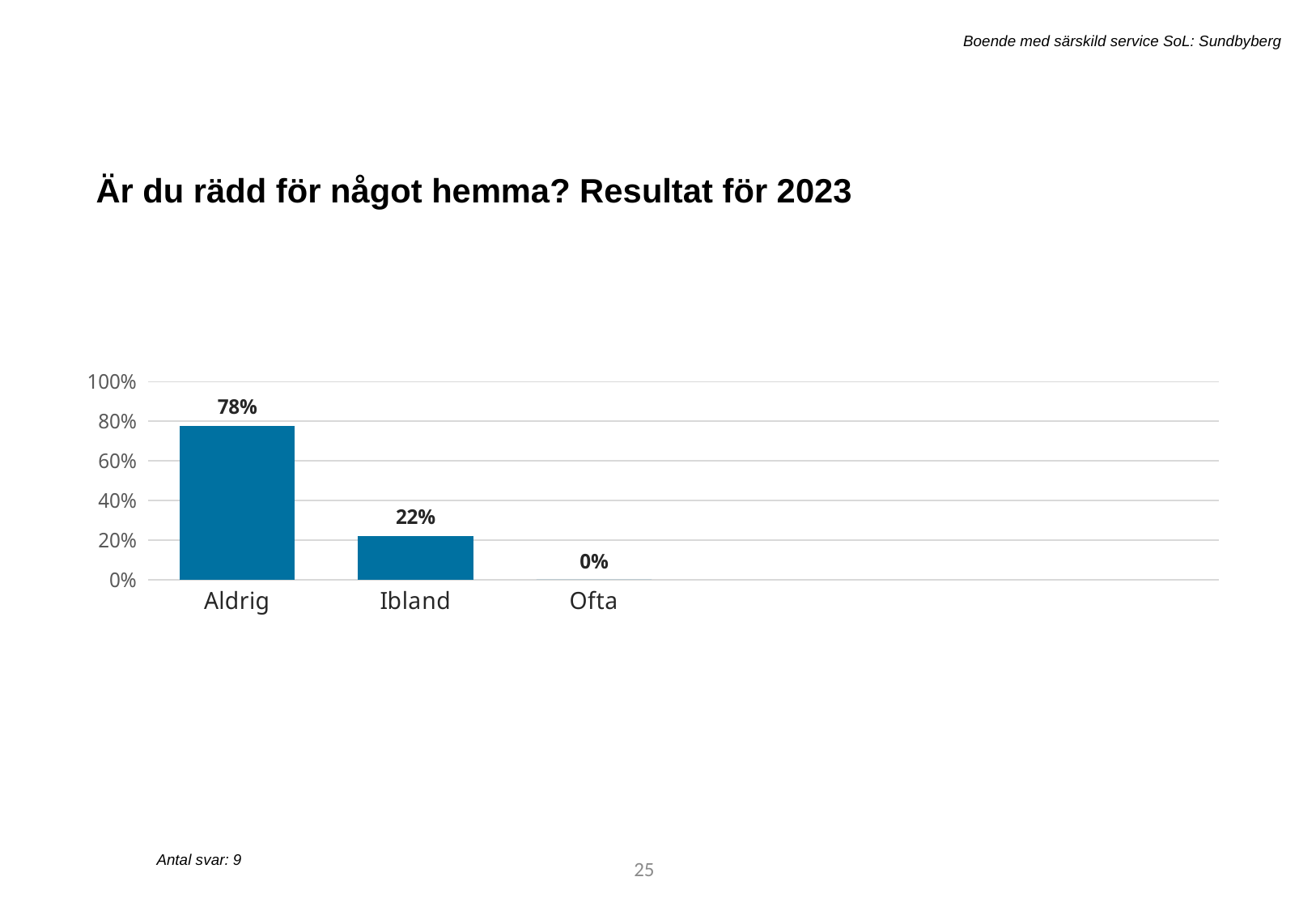
What is the difference between the values for Aldrig and Ibland? 56% What is the value for Aldrig? 78% What is the title of the chart? Är du rädd för något hemma? Resultat för 2023 Which category has the highest value? Aldrig Do the values rise or fall from left to right along the x axis? fall Is the value for Aldrig greater or less than 60%? greater What is the value for Ofta? 0% What is the value for Ibland? 22% What kind of chart is shown on the slide? bar chart Which category has the lowest value? Ofta Which is larger, the value for Ibland or the value for Ofta? Ibland How many categories are shown on the x axis? 3